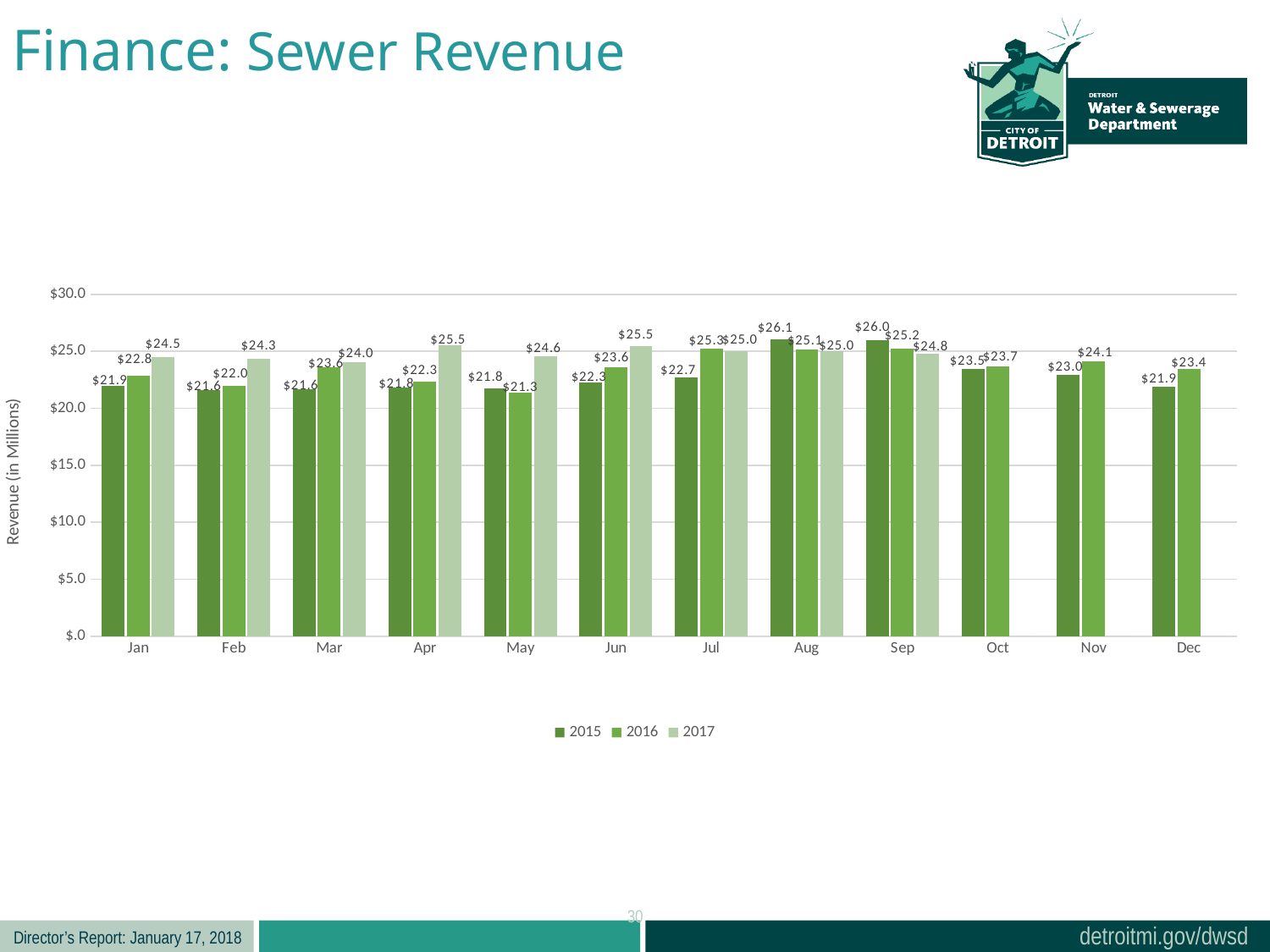
Which was larger, the sewer revenue in September 2015 or September 2017? September 2015 How many months are shown on the x axis? 12 What was the sewer revenue in December 2015? $21.9 What was the sewer revenue in April 2017? $25.5 In which month was the 2016 sewer revenue lowest? May What is the label on the y axis of the chart? Revenue (in Millions) How many series does the legend list? 3 Is the sewer revenue for August 2015 greater or less than $25.0? greater In which month was the 2015 sewer revenue highest? Aug What is the difference between the 2017 and 2015 sewer revenue in January? $2.6 What type of chart is shown on the slide? bar chart What was the sewer revenue in May 2016? $21.3